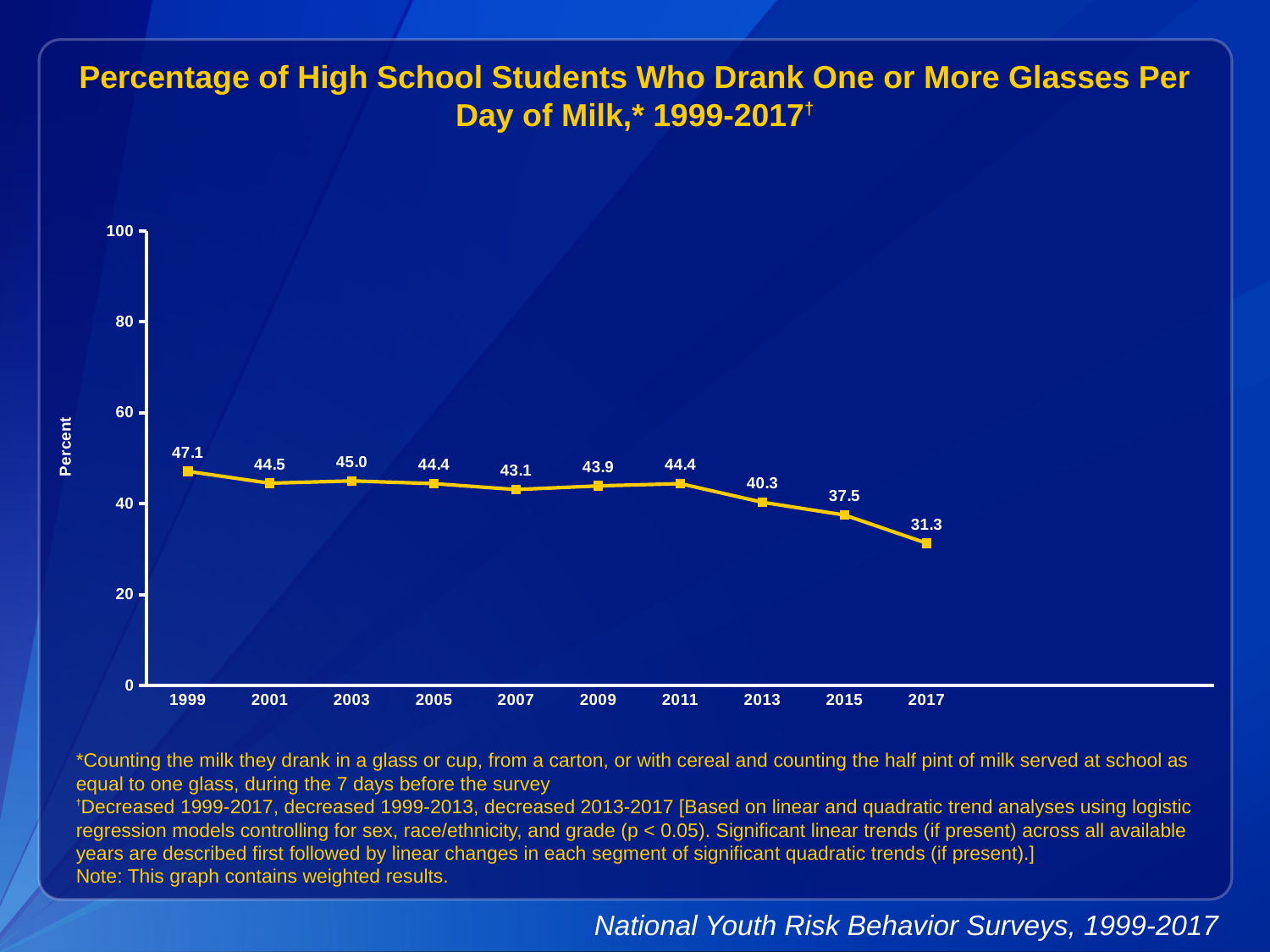
Do the values generally rise or fall from 1999 to 2017? Fall Which year has the larger value, 2013 or 2015? 2013 Is the value for 2011 greater or less than 40? greater What is the value plotted for 2017? 31.3 What percentage of high school students drank one or more glasses of milk per day in 1999? 47.1 How many years are plotted on the chart? 10 Which year has the lowest value on the chart? 2017 What is the label on the vertical axis? Percent What kind of chart is shown on the slide? Line chart What is the value plotted for 2007? 43.1 What is the difference between the 1999 value and the 2017 value? 15.8 Which year has the highest value on the chart? 1999